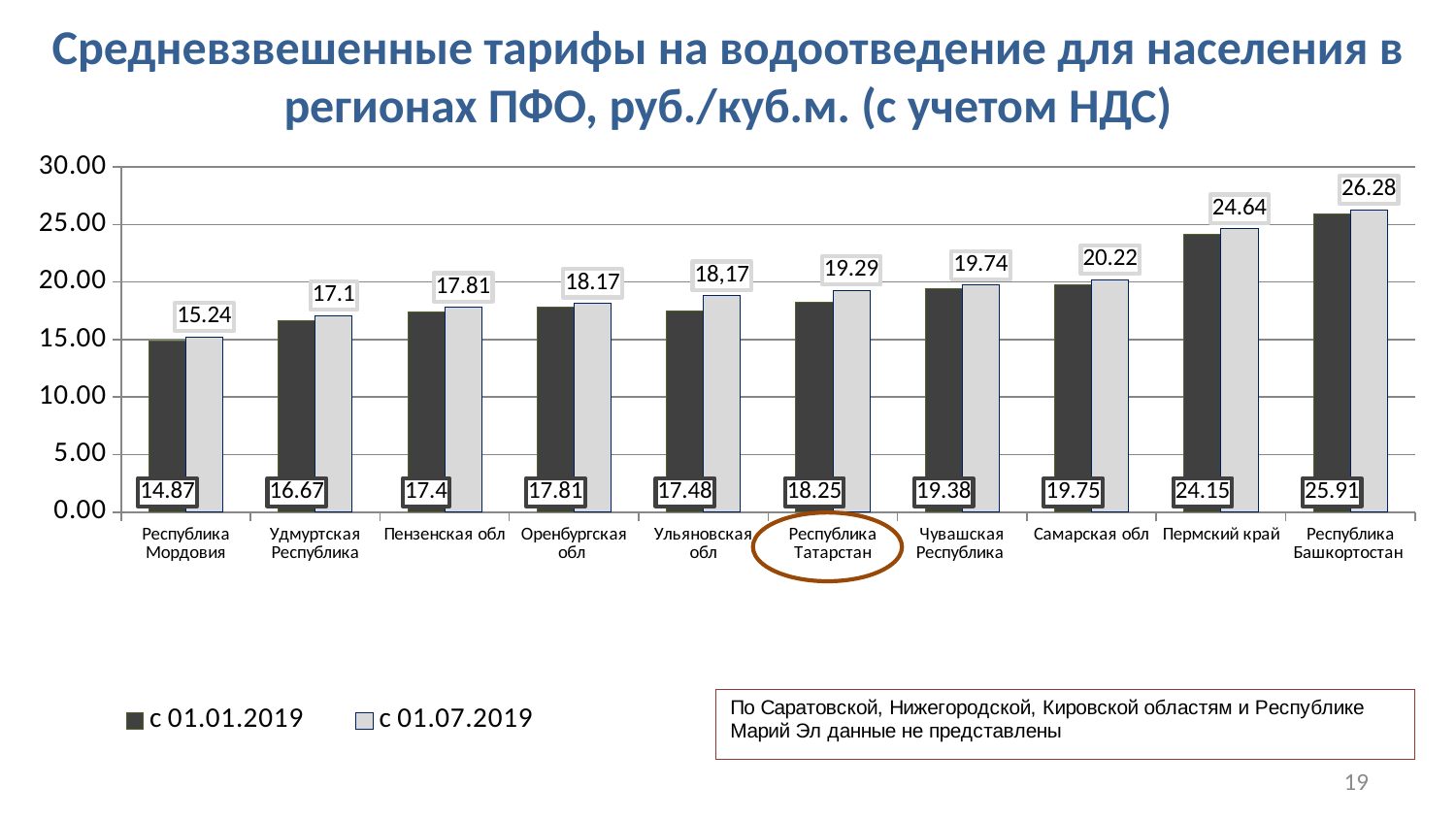
Which region has the highest value in the series с 01.07.2019? Республика Башкортостан How many regions are shown on the x axis of the chart? 10 Is the с 01.07.2019 value for Пермский край greater or less than 20.00? greater What kind of chart is shown on the slide? bar chart What is the value for Пермский край in the series с 01.01.2019? 24.15 Which region is circled on the x axis of the chart? Республика Татарстан What is the value for Республика Мордовия in the series с 01.07.2019? 15.24 What is the value for Республика Татарстан in the series с 01.07.2019? 19.29 How many series does the legend list? 2 Which is larger: the с 01.01.2019 value for Самарская обл or the с 01.01.2019 value for Чувашская Республика? Самарская обл What is the difference between the с 01.07.2019 and с 01.01.2019 values for Республика Татарстан? 1.04 Which region has the lowest value in the series с 01.01.2019? Республика Мордовия